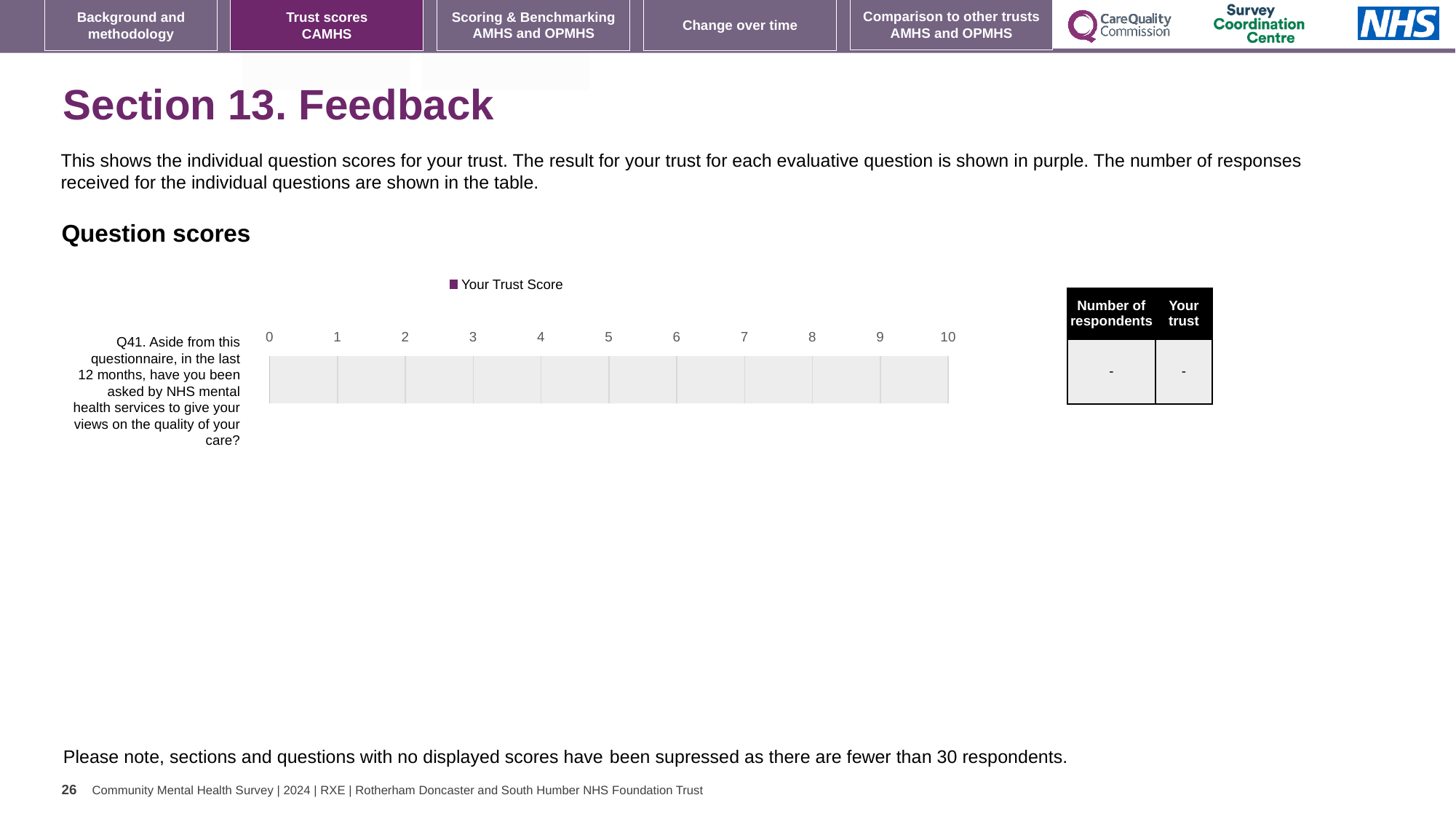
What is the highest value shown on the chart's horizontal axis? 10 What value is shown in the table under 'Your trust' for Q41? - How many series does the chart legend list? 1 How many questions (categories) are plotted on the chart? 1 What value is shown in the table for the number of respondents to Q41? - What is the name of the series shown in the chart legend? Your Trust Score Is a score bar displayed for Q41 on the chart? No What kind of chart is shown under 'Question scores'? bar chart